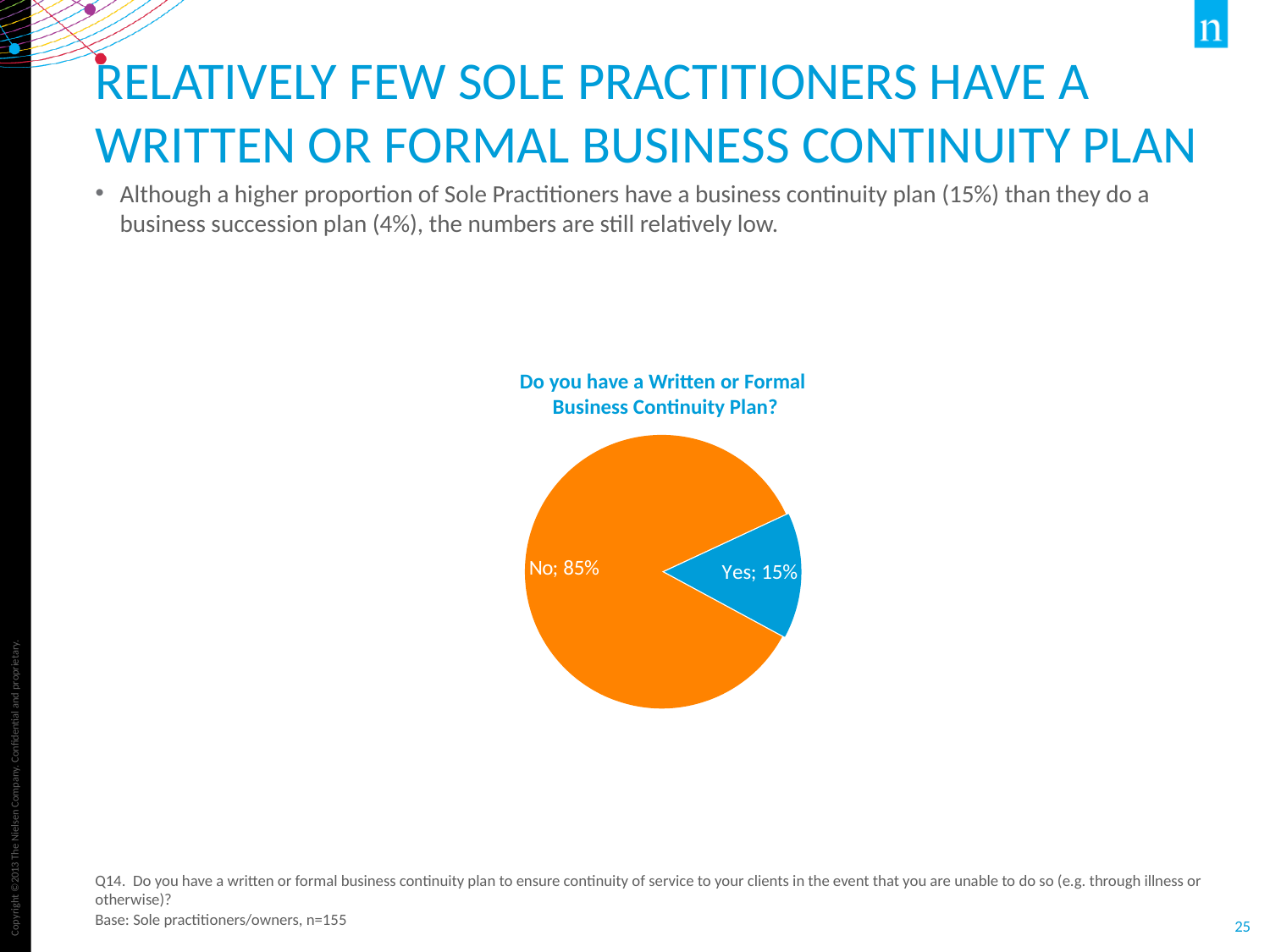
What colour is the "No" slice? orange What is the difference in percentage points between the "No" and "Yes" slices? 70 Which slice of the pie is the largest? No What type of chart is shown on the slide? pie chart What share of the pie does the "Yes" slice represent? 15% Which is larger, the "Yes" slice or the "No" slice? No Which slice of the pie is the smallest? Yes How many slices does the pie chart have? 2 What percentage of respondents answered "Yes"? 15% What percentage of respondents answered "No"? 85% What is the title of the chart? Do you have a Written or Formal Business Continuity Plan?